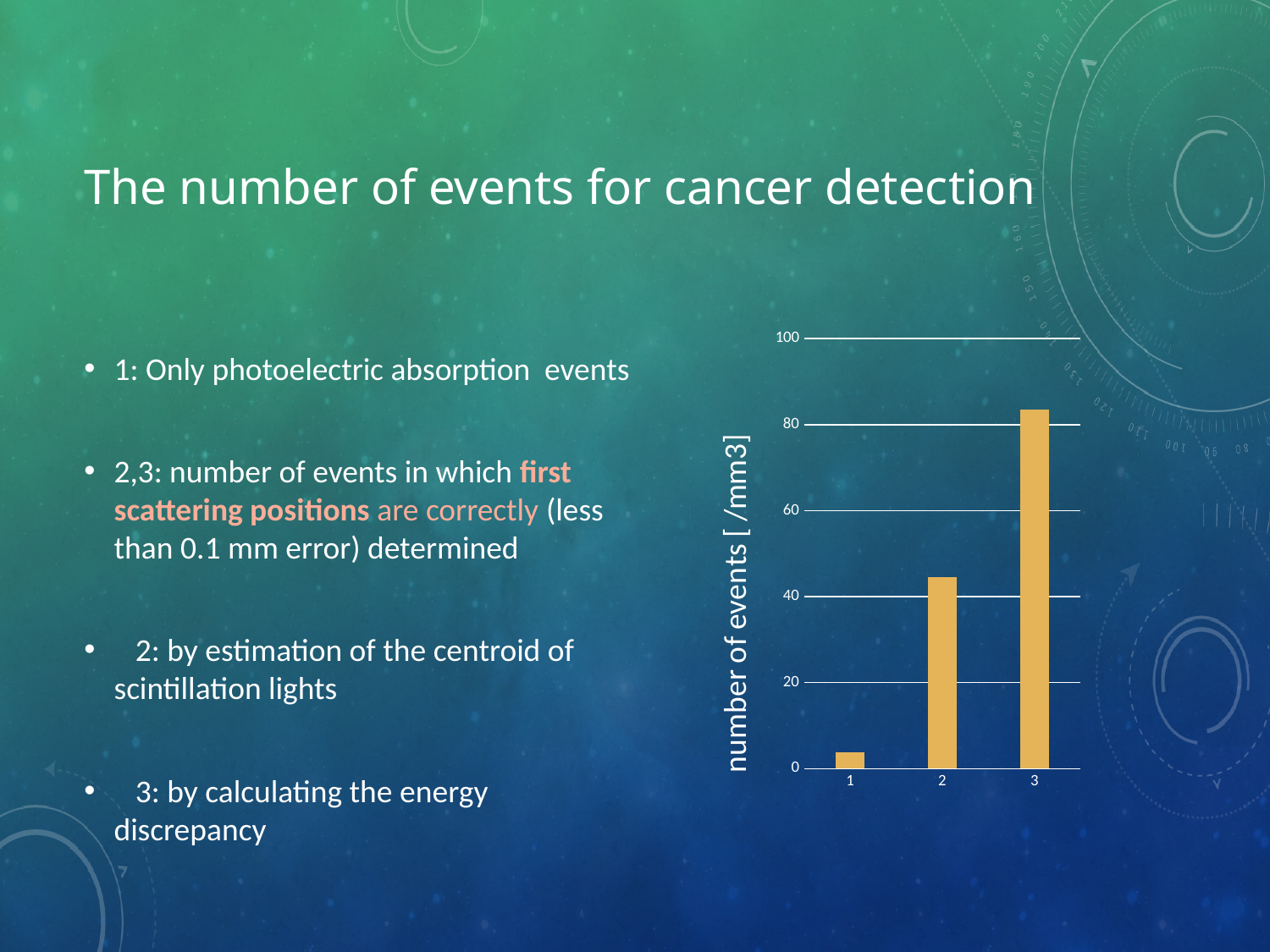
Which category has the lowest number of events? 1 Which category has the highest number of events? 3 Is the value for category 1 greater or less than 20? less Which has a larger value, category 2 or category 3? 3 Which has a larger value, category 1 or category 2? 2 What kind of chart is shown on the slide? bar chart Is the value for category 2 greater or less than 40? greater Do the values rise or fall from category 1 to category 3? rise Is the value for category 2 greater or less than 60? less How many categories are plotted on the x axis of the chart? 3 What is the label of the vertical axis of the chart? number of events [ /mm3]